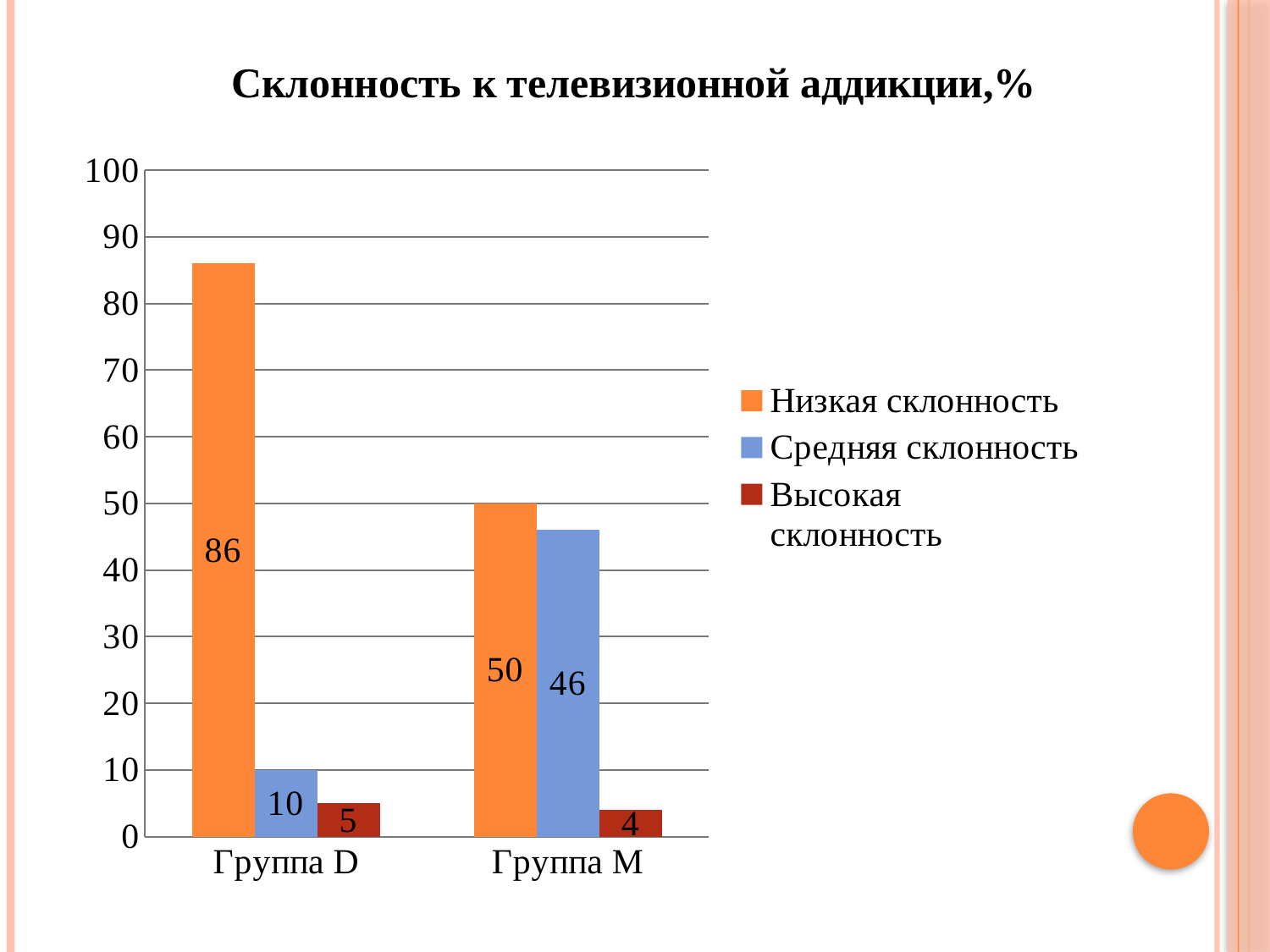
What is the title of the chart? Склонность к телевизионной аддикции,% Which series has the lowest value in Группа M? Высокая склонность Which is larger: Средняя склонность in Группа D or Средняя склонность in Группа M? Группа M What kind of chart is shown on the slide? Bar chart How many series does the legend list? 3 What is the value for Средняя склонность in Группа M? 46 What is the value for Низкая склонность in Группа M? 50 What is the value for Высокая склонность in Группа D? 5 How many categories are shown on the x axis? 2 What is the difference between Низкая склонность in Группа D and Низкая склонность in Группа M? 36 What is the value for Низкая склонность in Группа D? 86 Which series has the highest value in Группа D? Низкая склонность